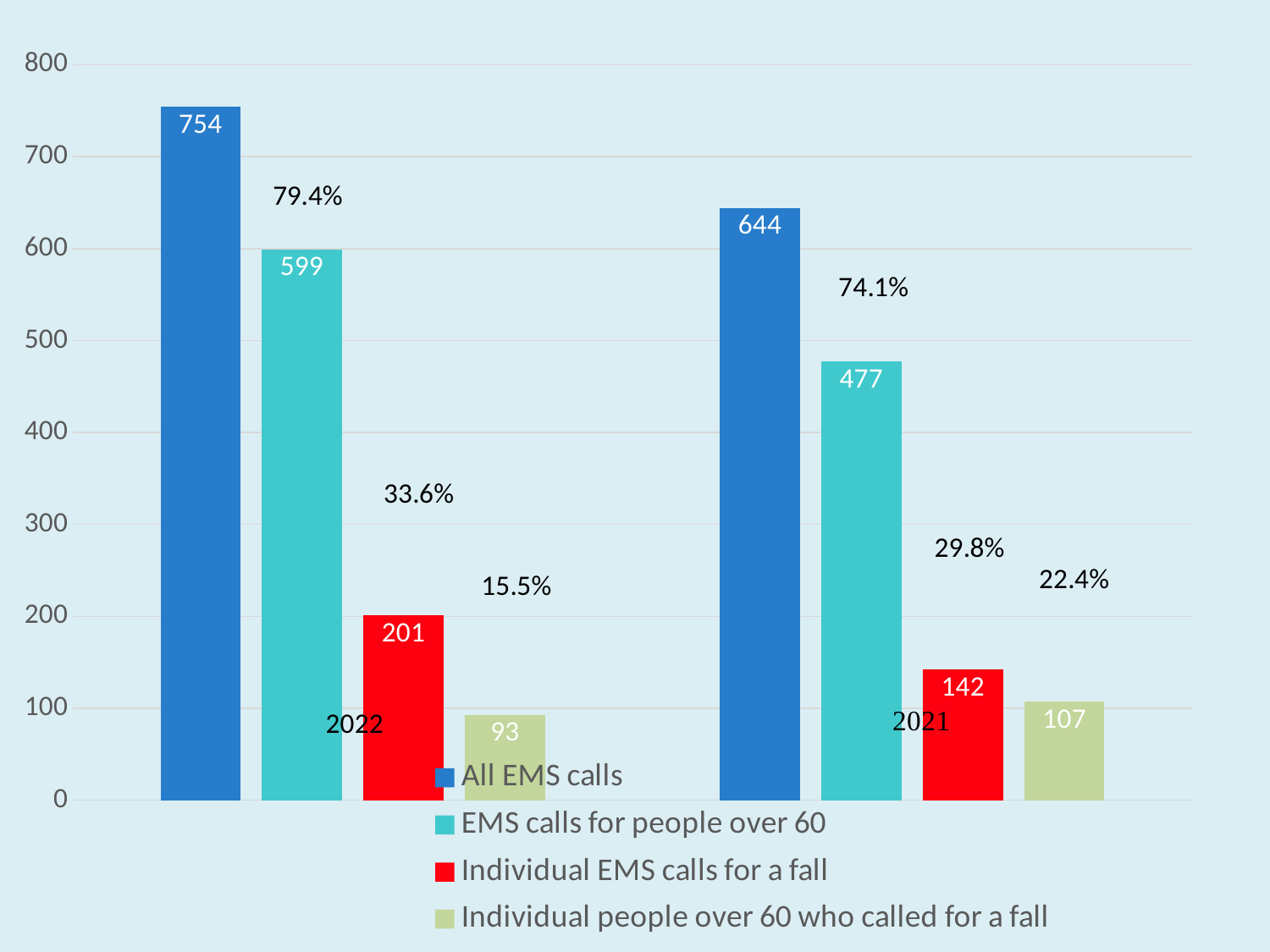
What is the difference between Individual EMS calls for a fall in 2022 and in 2021? 59 What is the value for Individual EMS calls for a fall in 2022? 201 How many year categories are shown on the x axis? 2 What is the difference between All EMS calls in 2022 and All EMS calls in 2021? 110 What kind of chart is shown on the slide? Bar chart What is the value for All EMS calls in 2022? 754 What percentage label is shown above the EMS calls for people over 60 bar for 2021? 74.1% What is the value for Individual people over 60 who called for a fall in 2021? 107 Which series has the lowest value in 2022? Individual people over 60 who called for a fall How many series does the legend list? 4 What is the value for EMS calls for people over 60 in 2021? 477 Which year has the higher value for All EMS calls, 2022 or 2021? 2022